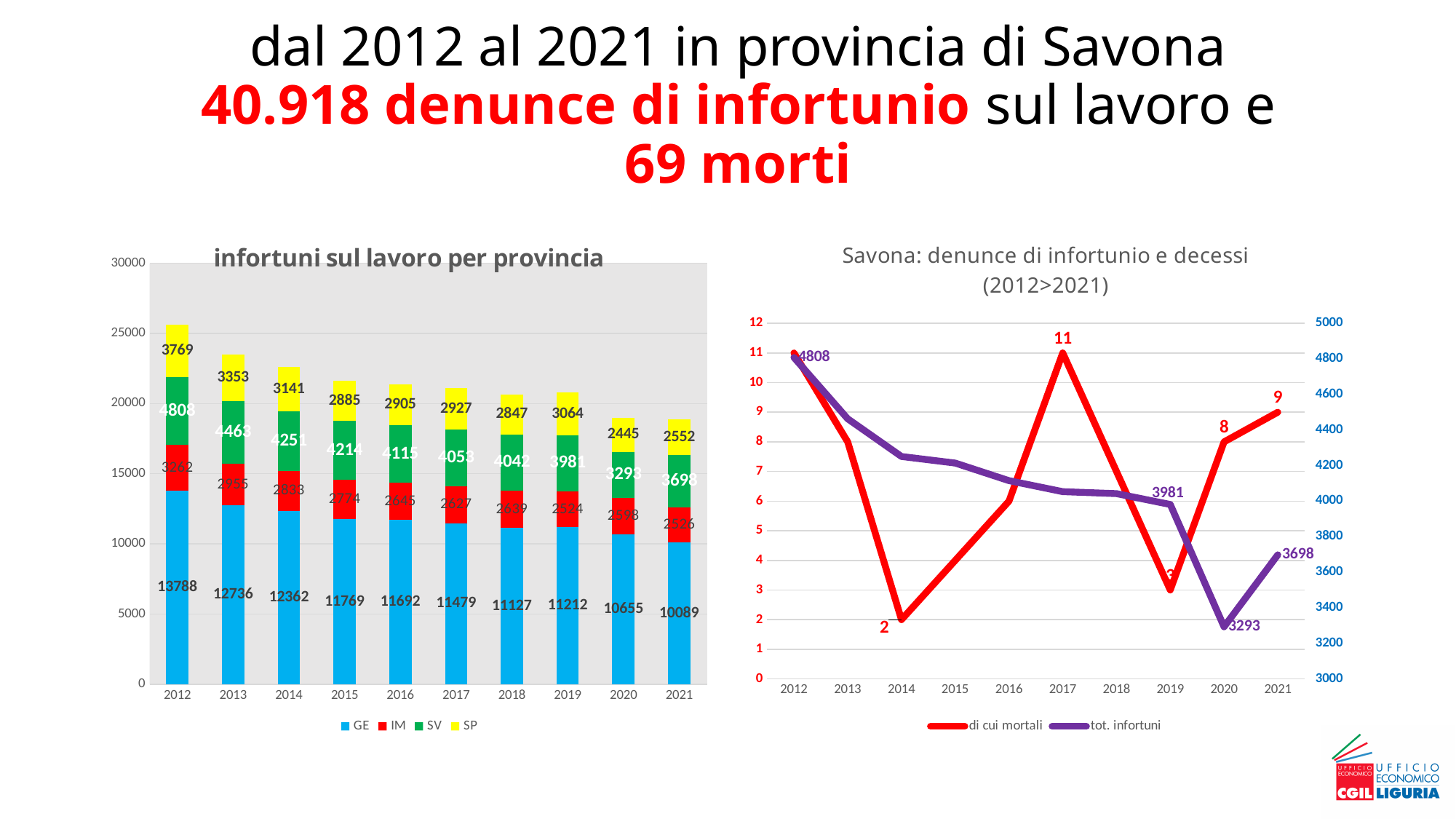
In the chart "infortuni sul lavoro per provincia", which is larger in 2012: IM or SP? SP In the chart "infortuni sul lavoro per provincia", how many series does the legend list? 4 In the chart "Savona: denunce di infortunio e decessi (2012>2021)", in which year is the "di cui mortali" value highest? 2012 and 2017 (tied at 11) In the chart "infortuni sul lavoro per provincia", what is the SP value for 2021? 2552 In the chart "infortuni sul lavoro per provincia", what is the difference between the SV value in 2012 and the SV value in 2021? 1110 In the chart "infortuni sul lavoro per provincia", which year has the highest GE value? 2012 In the chart "infortuni sul lavoro per provincia", what is the total of the stacked bar for 2021? 18865 What kind of chart is "Savona: denunce di infortunio e decessi (2012>2021)"? Line chart In the chart "infortuni sul lavoro per provincia", what is the GE value for 2012? 13788 In the chart "infortuni sul lavoro per provincia", does the GE value rise or fall from 2012 to 2021? Fall What kind of chart is "infortuni sul lavoro per provincia"? Bar chart In the chart "Savona: denunce di infortunio e decessi (2012>2021)", what is the "tot. infortuni" value for 2020? 3293